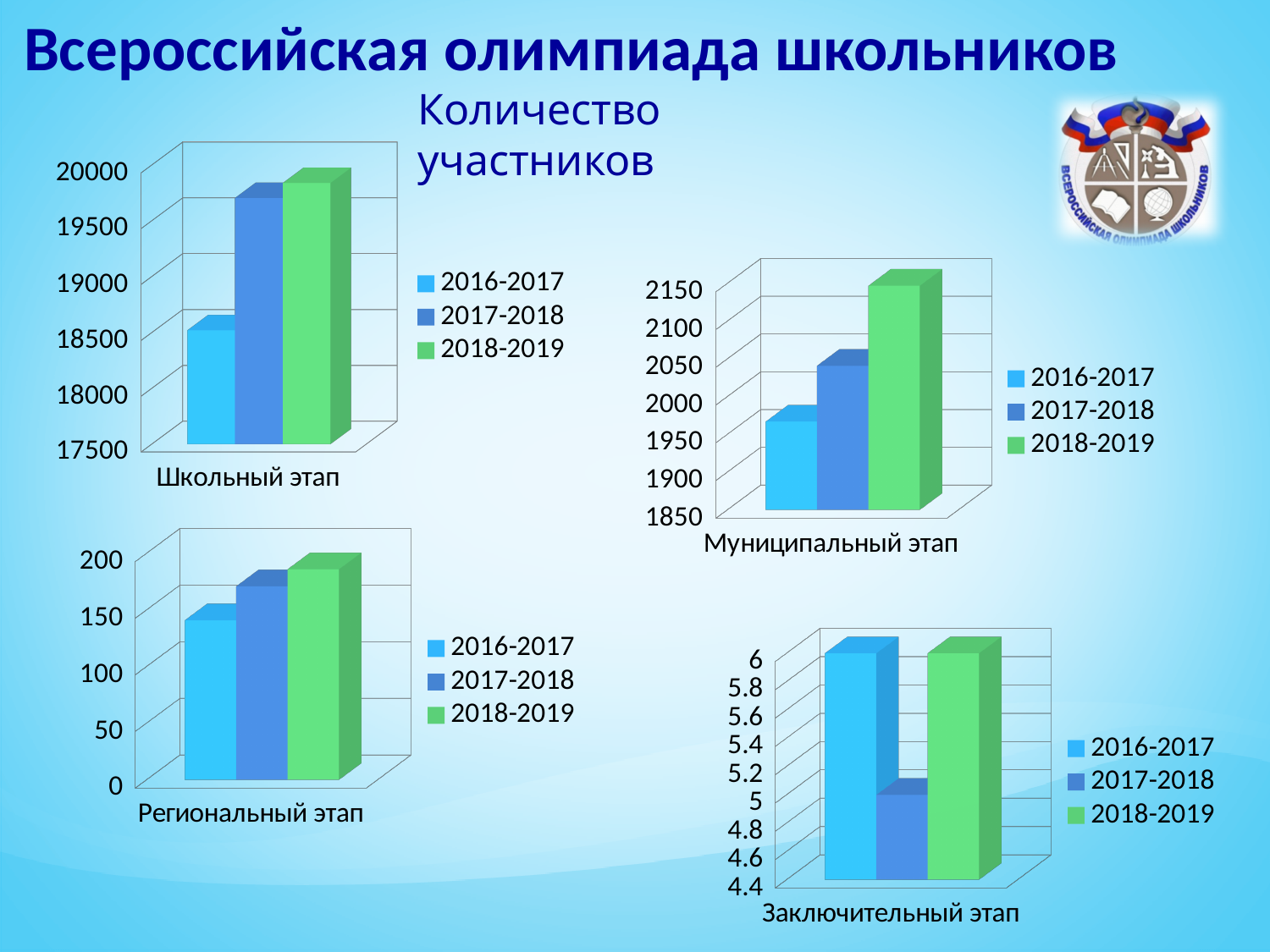
In the chart titled "Муниципальный этап", is the value for 2016-2017 greater or less than 2000? less In the chart titled "Школьный этап", is the value for 2017-2018 greater or less than 19000? greater In the chart titled "Школьный этап", which series has the lowest value? 2016-2017 In the chart titled "Муниципальный этап", is the value for 2018-2019 greater or less than 2100? greater In the chart titled "Заключительный этап", which series has the lowest value? 2017-2018 What kind of chart is the chart titled "Муниципальный этап"? bar chart In the chart titled "Муниципальный этап", which series has the highest value? 2018-2019 In the chart titled "Региональный этап", which series has the lowest value? 2016-2017 How many series does the legend of the chart titled "Региональный этап" list? 3